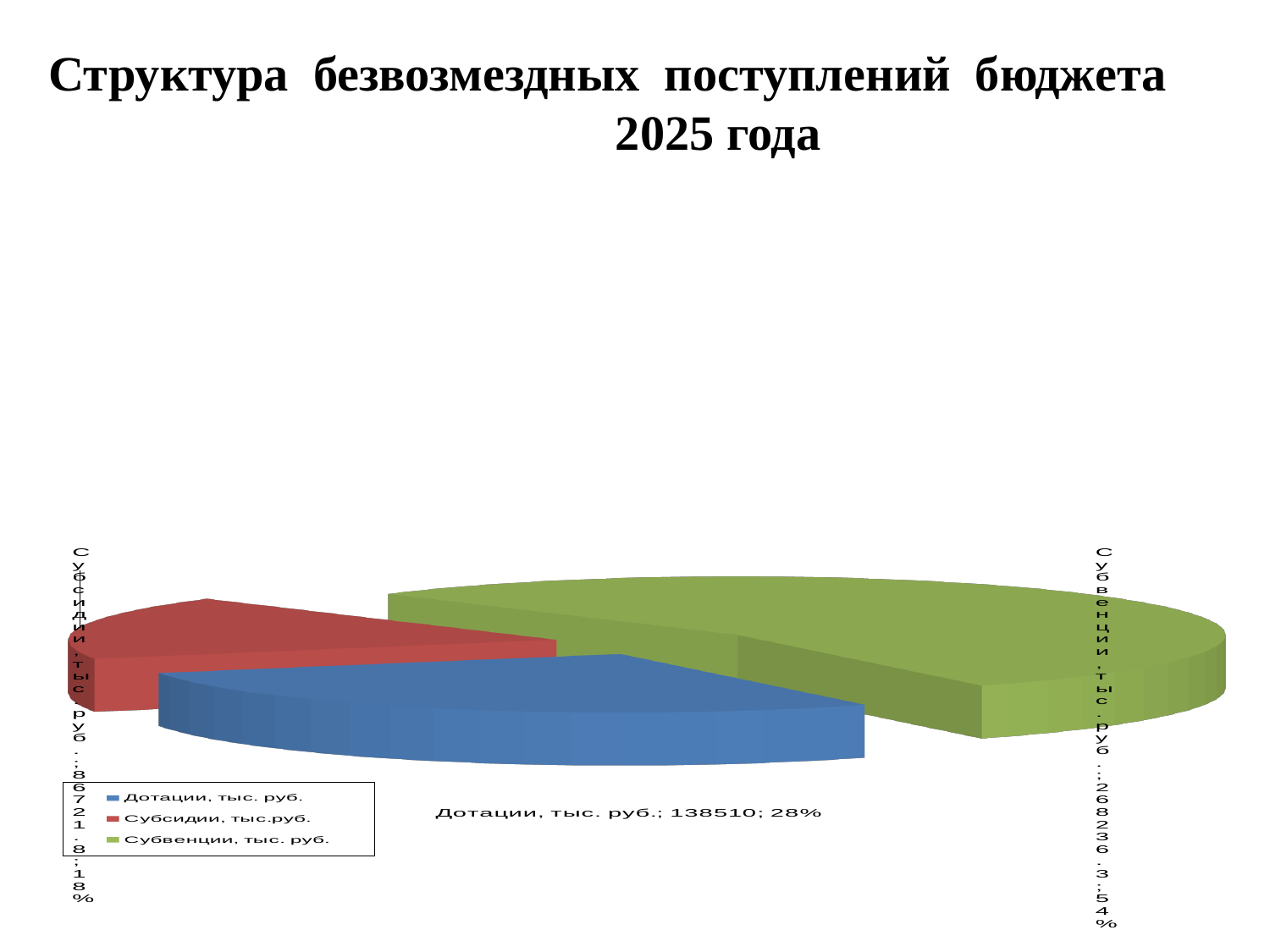
Which is larger, the value for Дотации or the value for Субсидии? Дотации How many entries does the legend list? 3 What is the value shown for Дотации, тыс. руб.? 138510 Which category has the smallest slice of the pie? Субсидии, тыс.руб. What is the title of the chart on the slide? Структура безвозмездных поступлений бюджета 2025 года What kind of chart is shown on the slide? pie chart What share of the pie does Субвенции, тыс. руб. represent? 54% Which category has the largest slice of the pie? Субвенции, тыс. руб. What is the value shown for Субвенции, тыс. руб.? 268236.3 What share of the pie does Субсидии, тыс.руб. represent? 18% How many slices does the pie chart have? 3 What share of the pie does Дотации, тыс. руб. represent? 28%